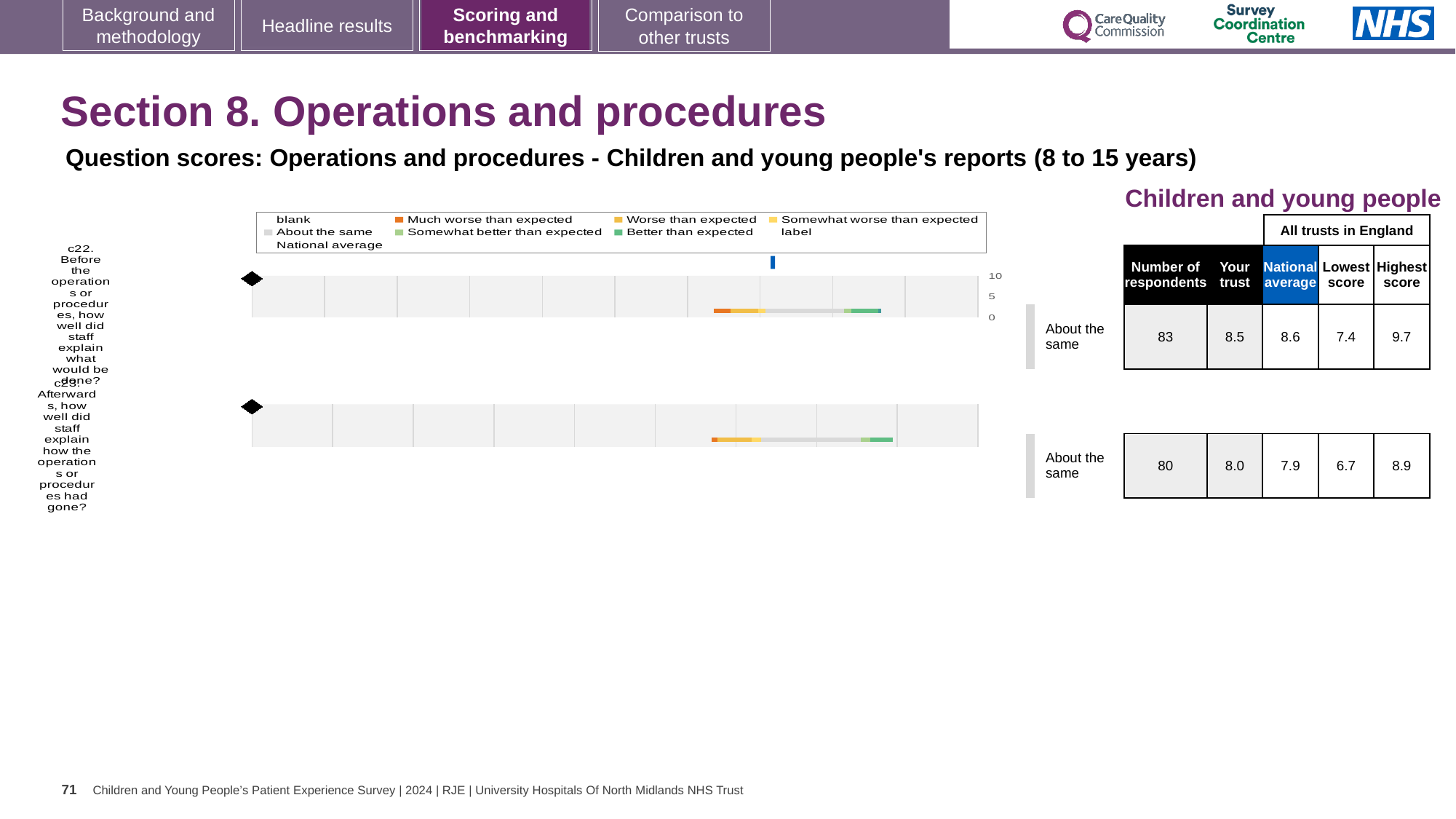
For c22, which is larger: the 'Your trust' score or the national average? National average For c23, what is the national average score? 7.9 How many survey questions (charts) are shown on the slide? 2 What kind of chart is used to show the question scores for c22 and c23? bar chart What is the lowest score among all trusts in England for c23? 6.7 What benchmark category label is shown next to both the c22 and c23 charts? About the same For c22, what is the national average score? 8.6 For c22, what is the difference between the highest score (9.7) and the lowest score (7.4) among all trusts in England? 2.3 How many respondents answered c22? 83 What is the highest score among all trusts in England for c23? 8.9 For c22 (Before the operations or procedures, how well did staff explain what would be done?), what is the 'Your trust' score? 8.5 For c23 (Afterwards, how well did staff explain how the operations or procedures had gone?), what is the 'Your trust' score? 8.0